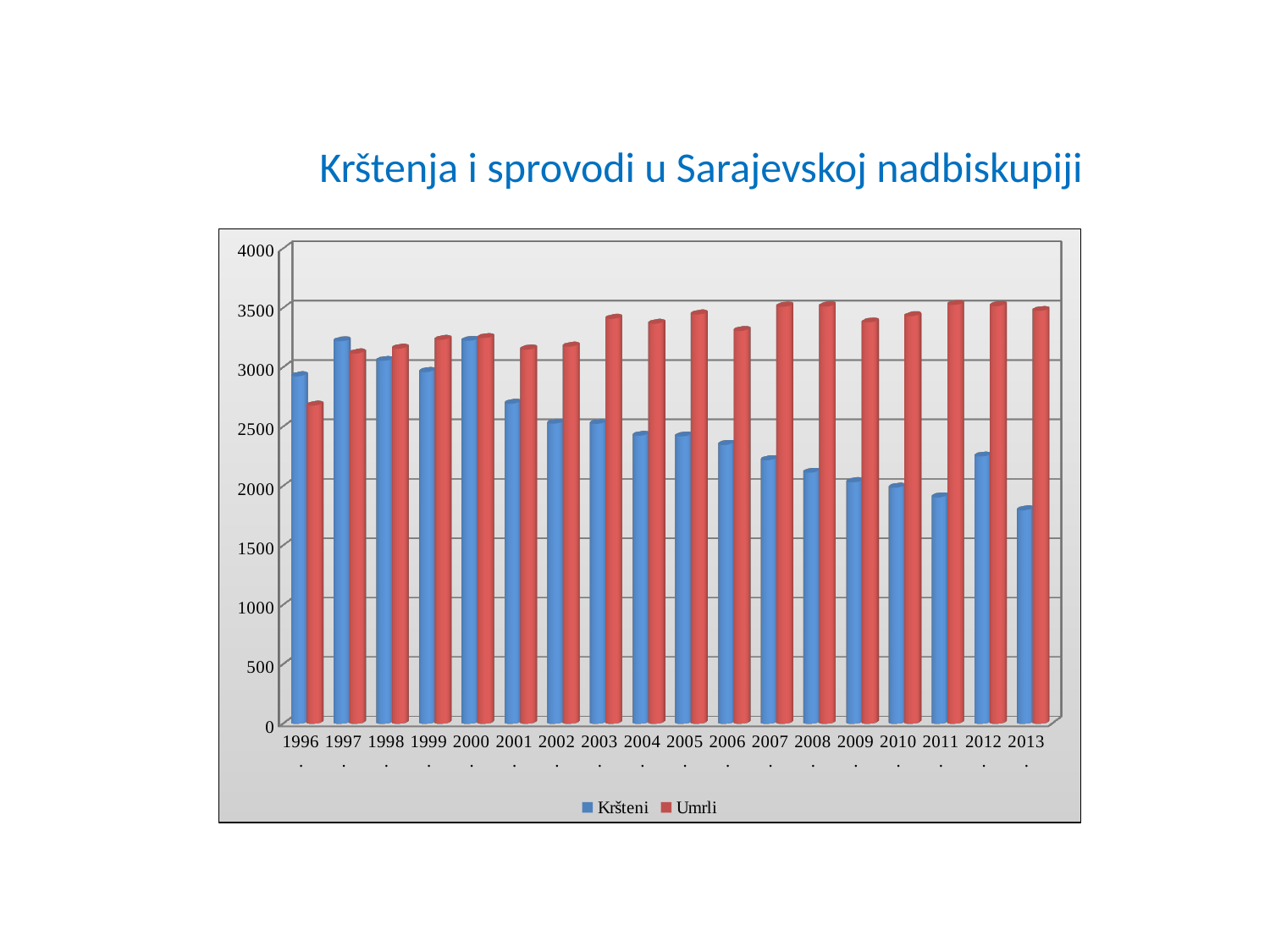
Do the values for Kršteni generally rise or fall from 1996 to 2013? fall Is the value for Umrli in 2003 greater or less than 3000? greater How many years are shown on the x axis? 18 In 1996, which is larger, Kršteni or Umrli? Kršteni Which year has the lowest value for Umrli? 1996 Is the value for Kršteni in 2001 greater or less than 2500? greater What is the title of the chart? Krštenja i sprovodi u Sarajevskoj nadbiskupiji What kind of chart is shown on the slide? bar chart In 2013, which is larger, Kršteni or Umrli? Umrli How many series does the legend list? 2 Which year has the lowest value for Kršteni? 2013 Is the value for Kršteni in 2013 greater or less than 2000? less